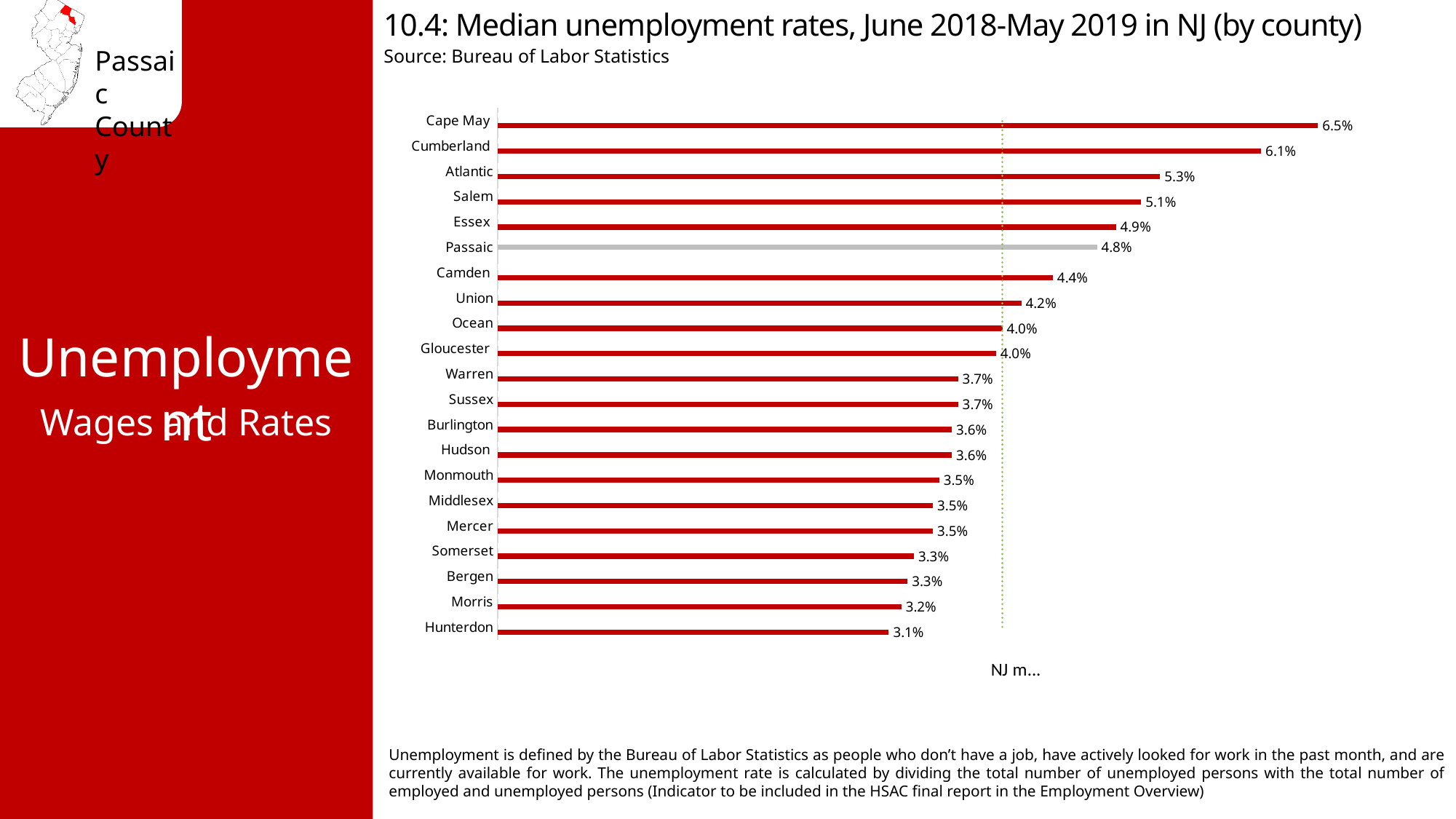
Which county's bar is shown in grey rather than red? Passaic Which county has the lowest median unemployment rate? Hunterdon What kind of chart is shown on the slide? Bar chart What is the median unemployment rate for Cumberland county? 6.1% How many counties are shown in the chart? 21 What is the difference between the median unemployment rates of Passaic and Camden? 0.4% Which county has the highest median unemployment rate? Cape May What is the median unemployment rate for Hudson county? 3.6% Which county has a higher median unemployment rate, Atlantic or Salem? Atlantic What is the difference between the median unemployment rates of Cape May and Hunterdon? 3.4% Which county has a higher median unemployment rate, Essex or Union? Essex What is the median unemployment rate for Passaic county? 4.8%